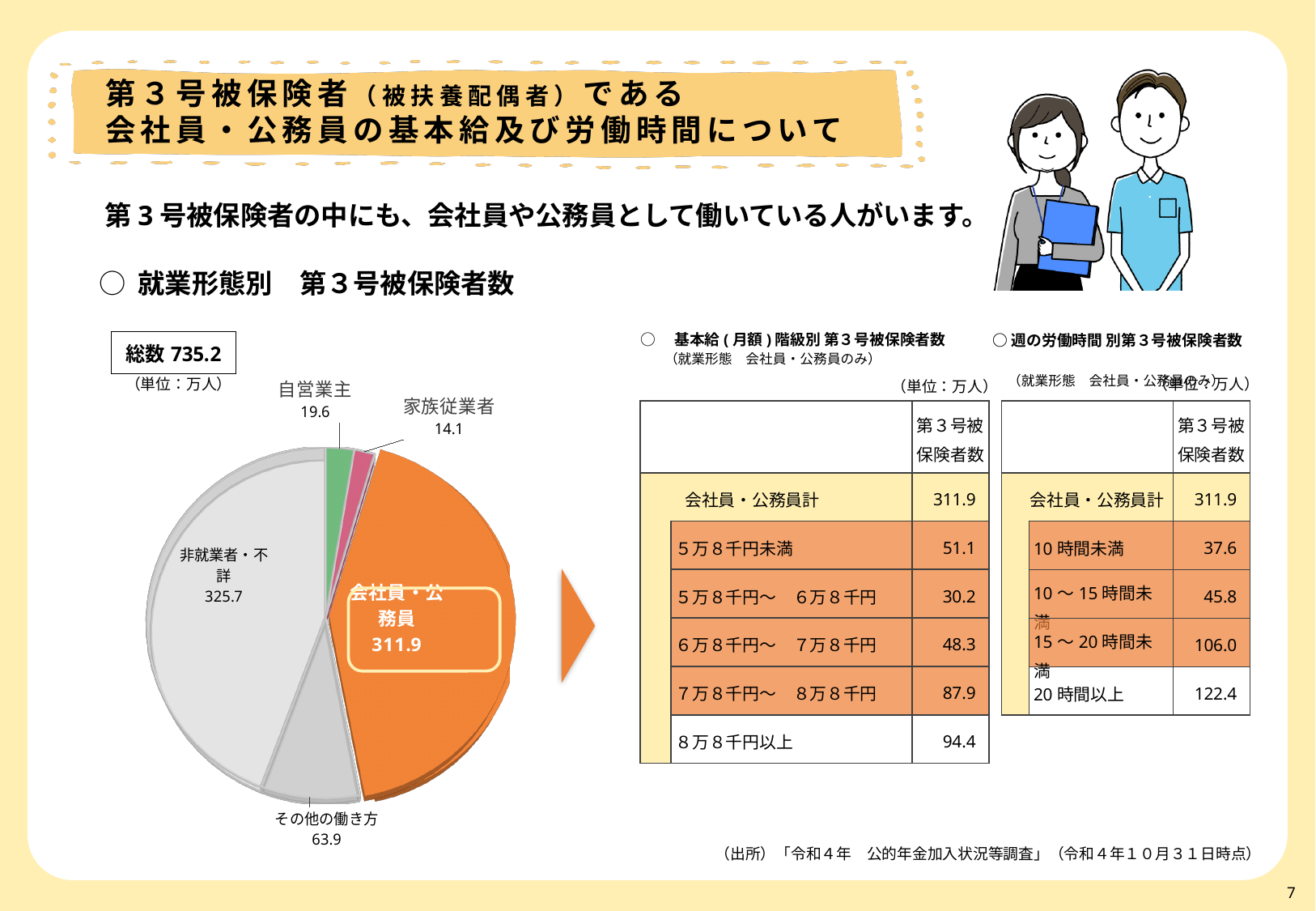
Which category has the largest slice in the pie chart? 非就業者・不詳 In the pie chart, which is larger: 自営業主 or 家族従業者? 自営業主 In the pie chart, what is the value for 非就業者・不詳? 325.7 In the pie chart, what is the value for 会社員・公務員? 311.9 In the pie chart, what is the value for その他の働き方? 63.9 What total (総数) is shown for the pie chart, in 万人? 735.2 In the pie chart, what is the difference between 非就業者・不詳 and 会社員・公務員? 13.8 In the pie chart, what is the value for 自営業主? 19.6 Which category has the smallest slice in the pie chart? 家族従業者 In the pie chart, what is the value for 家族従業者? 14.1 What kind of chart is shown on the left of the slide (就業形態別 第３号被保険者数)? pie chart How many slices does the pie chart have? 5